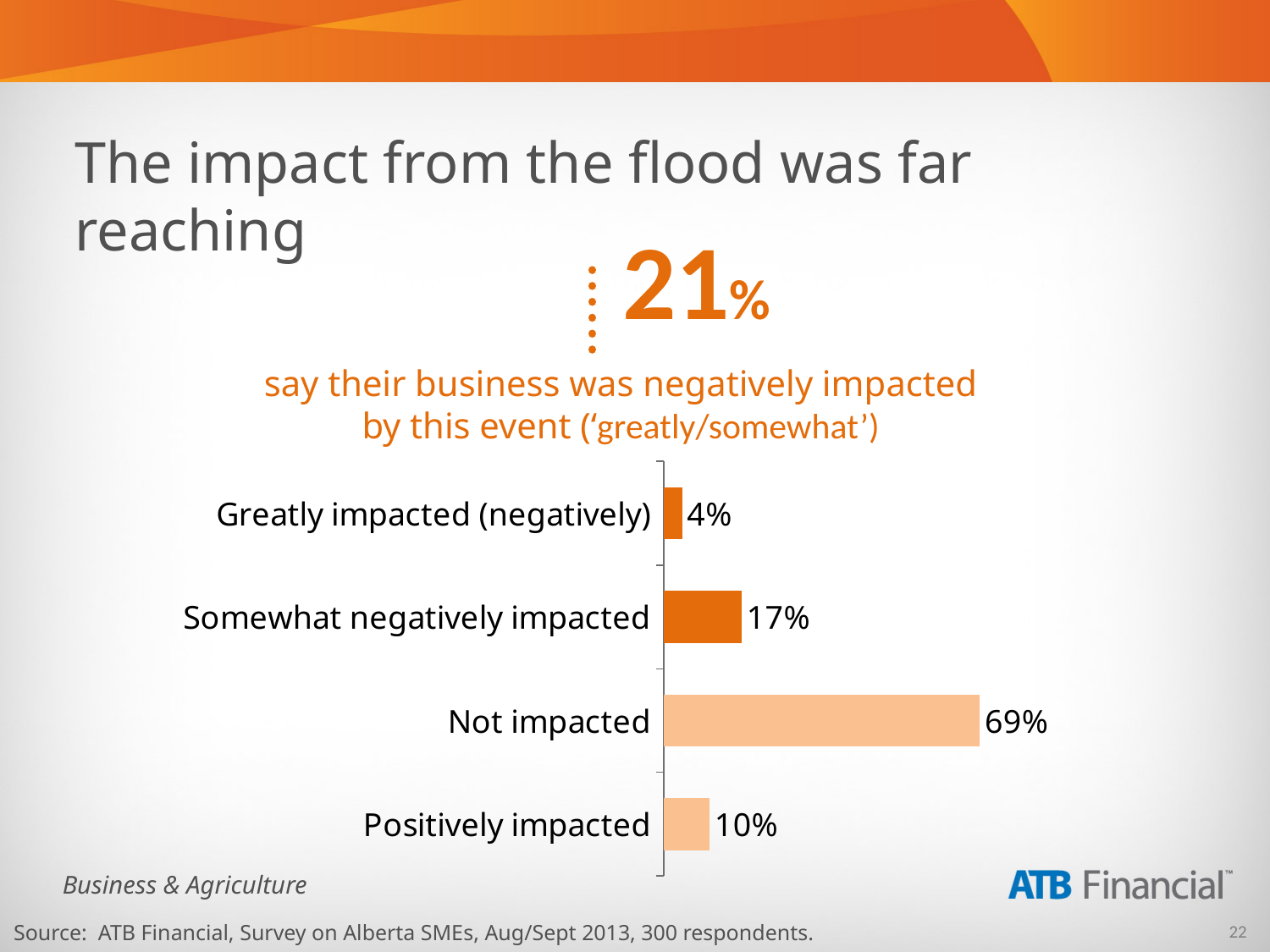
What is the difference between 'Positively impacted' and 'Greatly impacted (negatively)'? 6% What is the value for 'Somewhat negatively impacted'? 17% What is the value for 'Positively impacted'? 10% Which is larger: 'Somewhat negatively impacted' or 'Positively impacted'? Somewhat negatively impacted What percentage of respondents said their business was not impacted? 69% Which category has the lowest value? Greatly impacted (negatively) What percentage of respondents said their business was greatly impacted (negatively) by the flood? 4% How many categories are shown in the chart? 4 What is the difference between the 'Not impacted' and 'Somewhat negatively impacted' values? 52% Which category has the highest value? Not impacted What kind of chart is shown on the slide? Bar chart According to the highlighted figure on the slide, what percentage say their business was negatively impacted by the flood? 21%